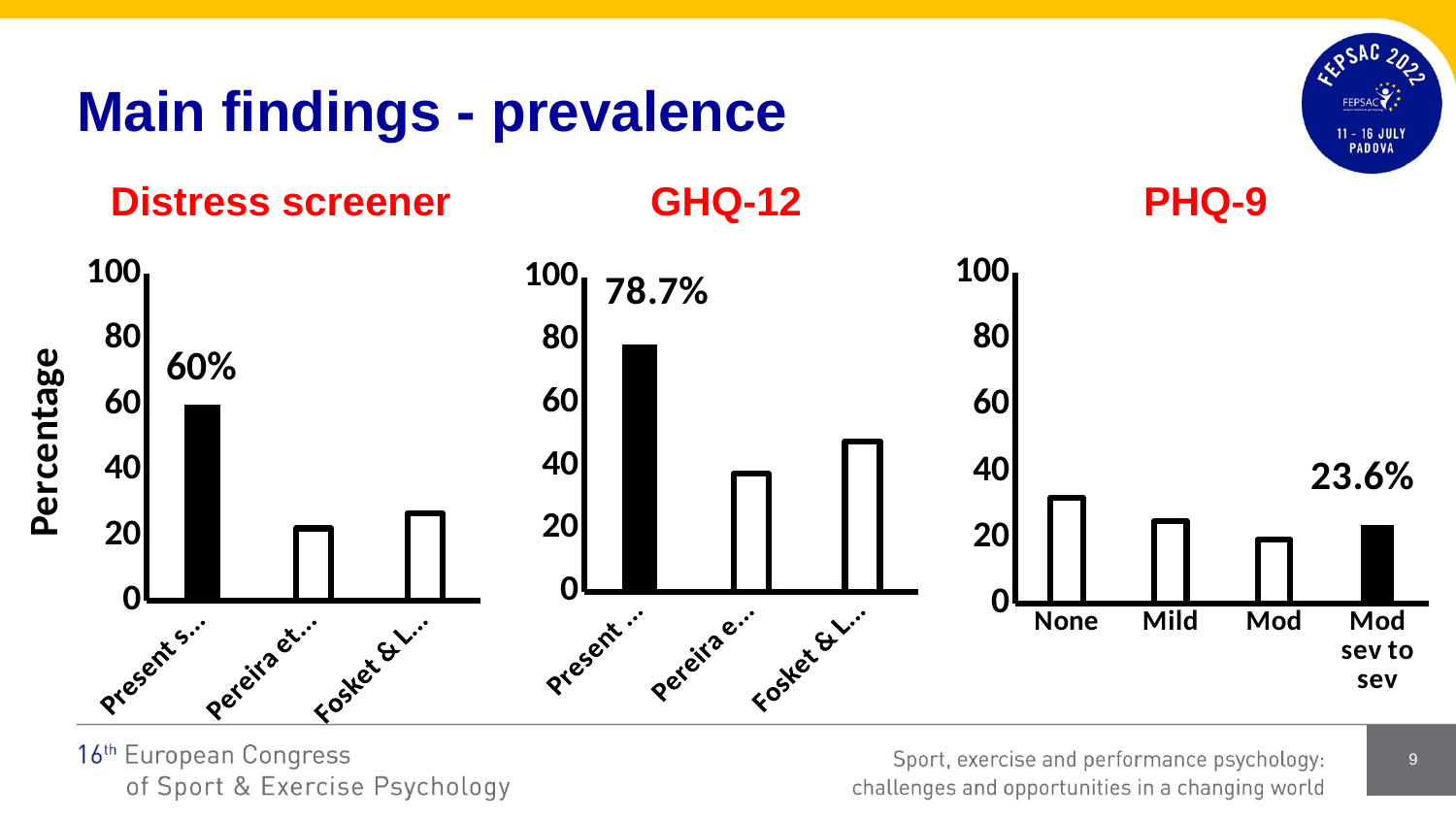
What type of chart is used for the Distress screener, GHQ-12 and PHQ-9 data? Bar chart What is the label on the vertical axis to the left of the Distress screener chart? Percentage In the GHQ-12 chart, which is larger, the bar for 'Pereira e...' or the bar for 'Fosket & L...'? Fosket & L... In the GHQ-12 chart, is the value for 'Fosket & L...' greater or less than 40? greater In the PHQ-9 chart, which category has the lowest bar? Mod How many categories are shown in the PHQ-9 chart? 4 In the GHQ-12 chart, what value is labelled on the first (black) bar for 'Present ...'? 78.7% In the Distress screener chart, what value is labelled on the first (black) bar for 'Present s...'? 60% In the PHQ-9 chart, which category has the highest bar? None In the Distress screener chart, is the value for 'Fosket & L...' greater or less than 40? less In the PHQ-9 chart, what value is labelled on the 'Mod sev to sev' bar? 23.6% How many bars are shown in the GHQ-12 chart? 3